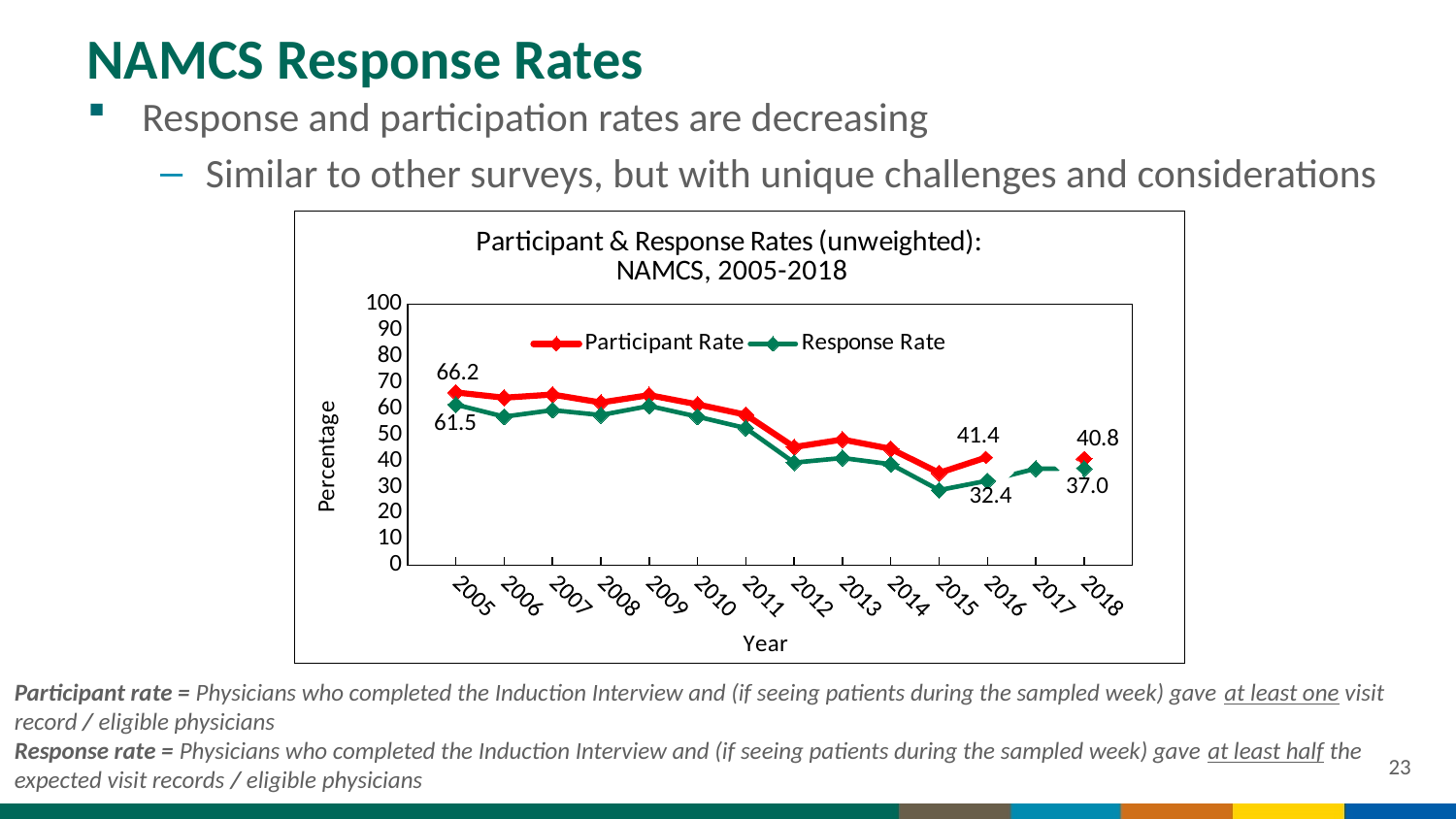
By how much did the Participant Rate fall from 2005 to 2016? 24.8 What is the difference between the Participant Rate and the Response Rate in 2005? 4.7 Is the Participant Rate for 2012 greater or less than 50? less How many years are shown on the x axis? 14 How many series does the legend list? 2 What was the Participant Rate in 2005? 66.2 What type of chart is shown on the slide? Line chart What is the title of the chart? Participant & Response Rates (unweighted): NAMCS, 2005-2018 Which year has the lowest Response Rate? 2015 Which year has the highest Participant Rate? 2005 What was the Participant Rate in 2018? 40.8 What was the Response Rate in 2016? 32.4